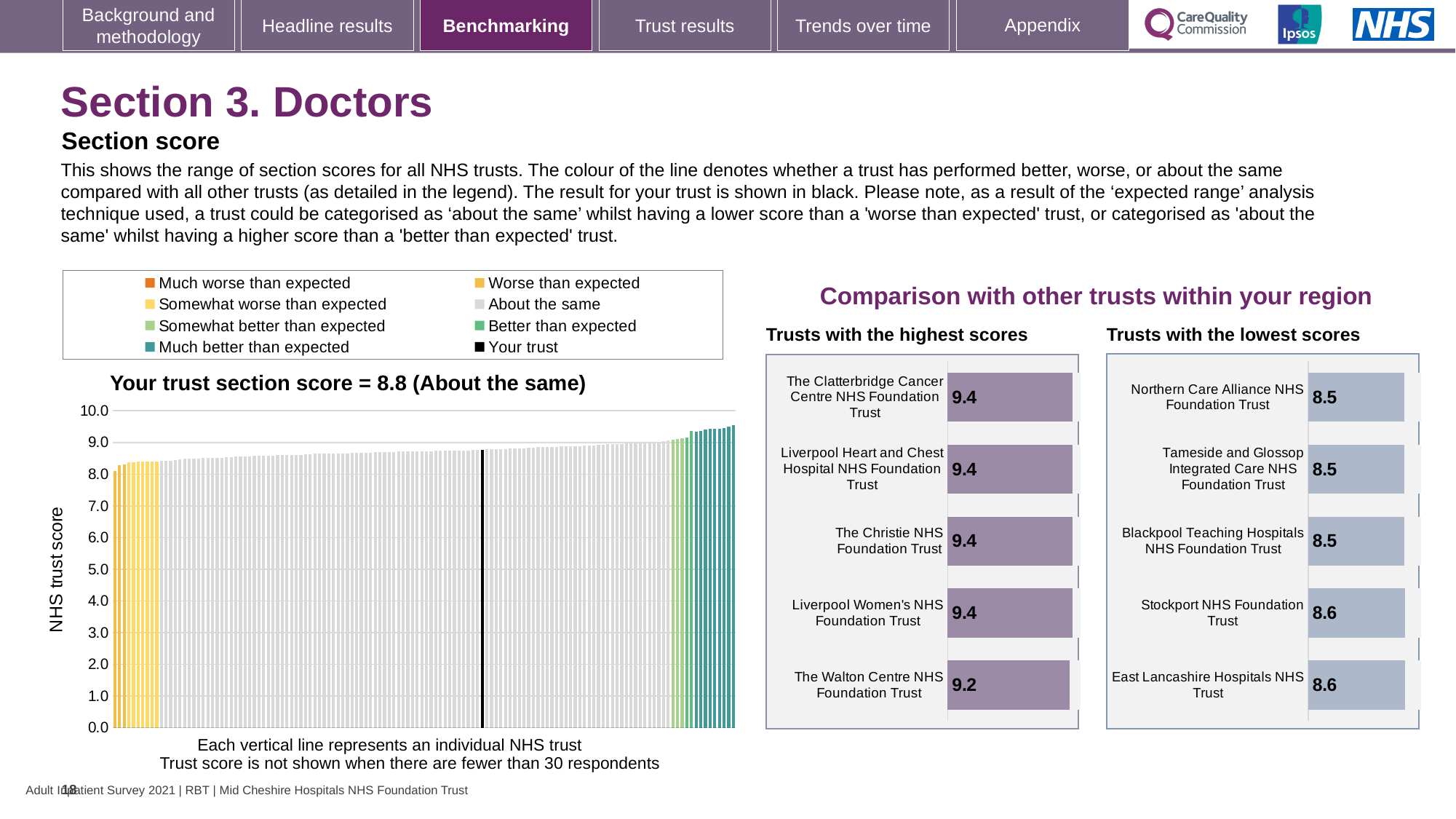
According to the title of the main section score chart on the left, what is your trust's section score? 8.8 In the 'Trusts with the highest scores' chart, what is the score for The Christie NHS Foundation Trust? 9.4 How many trusts are shown in the 'Trusts with the lowest scores' chart? 5 In the 'Trusts with the lowest scores' chart, what is the score for Blackpool Teaching Hospitals NHS Foundation Trust? 8.5 In the 'Trusts with the lowest scores' chart, which is larger: the score for East Lancashire Hospitals NHS Trust or Northern Care Alliance NHS Foundation Trust? East Lancashire Hospitals NHS Trust In the 'Trusts with the highest scores' chart, which trust has the lowest score? The Walton Centre NHS Foundation Trust In the 'Trusts with the highest scores' chart, what is the score for The Walton Centre NHS Foundation Trust? 9.2 In the 'Trusts with the lowest scores' chart, what is the score for Stockport NHS Foundation Trust? 8.6 What kind of chart is the main section score chart on the left of the slide? Bar chart In the 'Trusts with the highest scores' chart, what is the difference between the score for The Clatterbridge Cancer Centre NHS Foundation Trust and The Walton Centre NHS Foundation Trust? 0.2 How many entries does the legend above the main section score chart list? 8 In the main section score chart on the left, is the value of the lowest-scoring trust greater or less than 7.0? greater